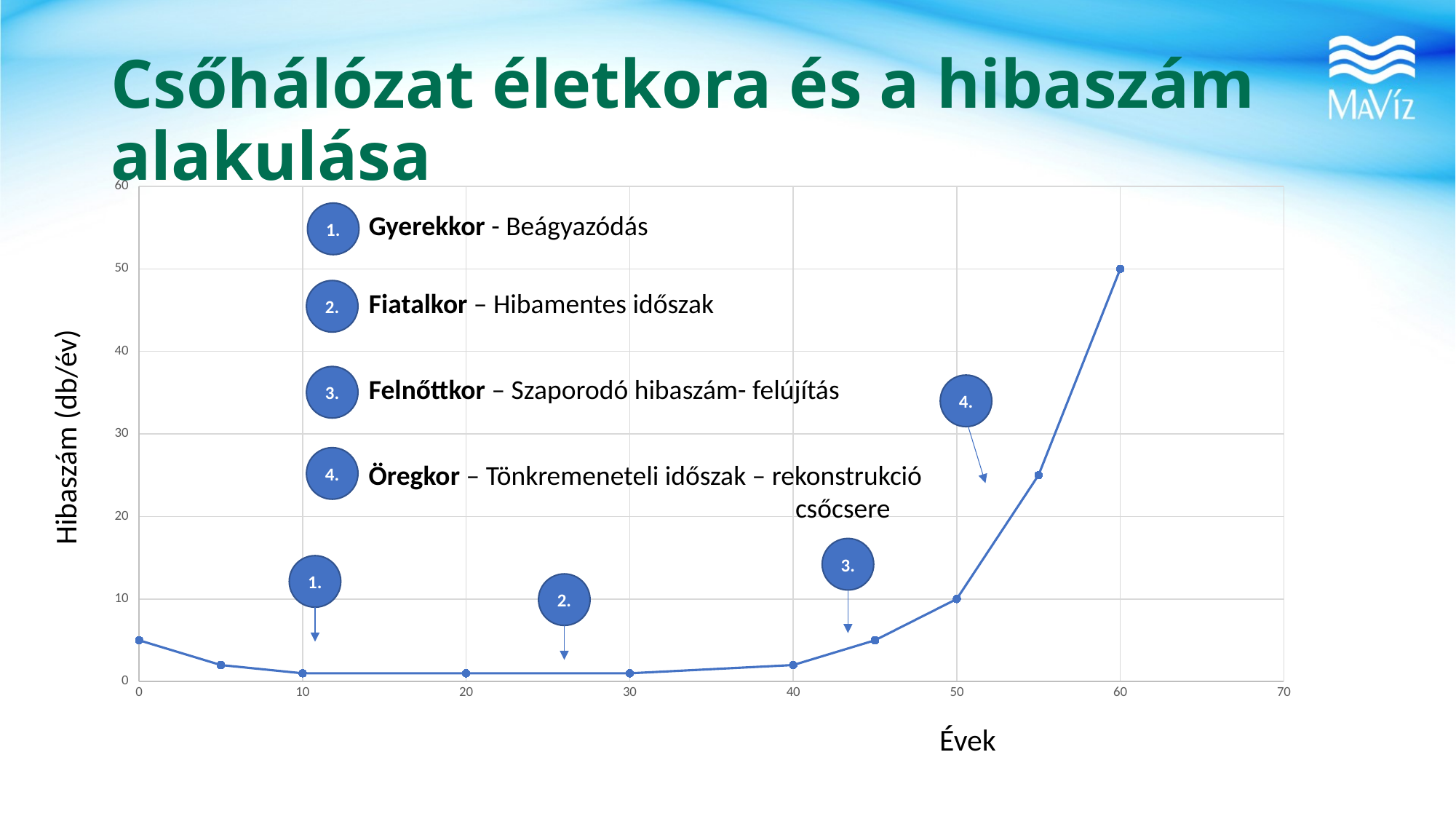
At which value of Évek is the Hibaszám highest? 60 Is the value of Hibaszám at 45 years greater or less than 10? less Is the value of Hibaszám at 55 years greater or less than 20? greater Which is larger, the Hibaszám at 0 years or at 55 years? 55 years What is the value of Hibaszám at 60 years (Évek)? 50 What is the value of Hibaszám at 50 years (Évek)? 10 What is the label of the y axis? Hibaszám (db/év) What kind of chart is shown on the slide? line chart Does the Hibaszám rise or fall between 40 and 60 years on the x axis? rise What is the difference between the Hibaszám at 60 years and at 50 years? 40 How many data points are plotted on the line? 10 What is the title of the slide containing the chart? Csőhálózat életkora és a hibaszám alakulása